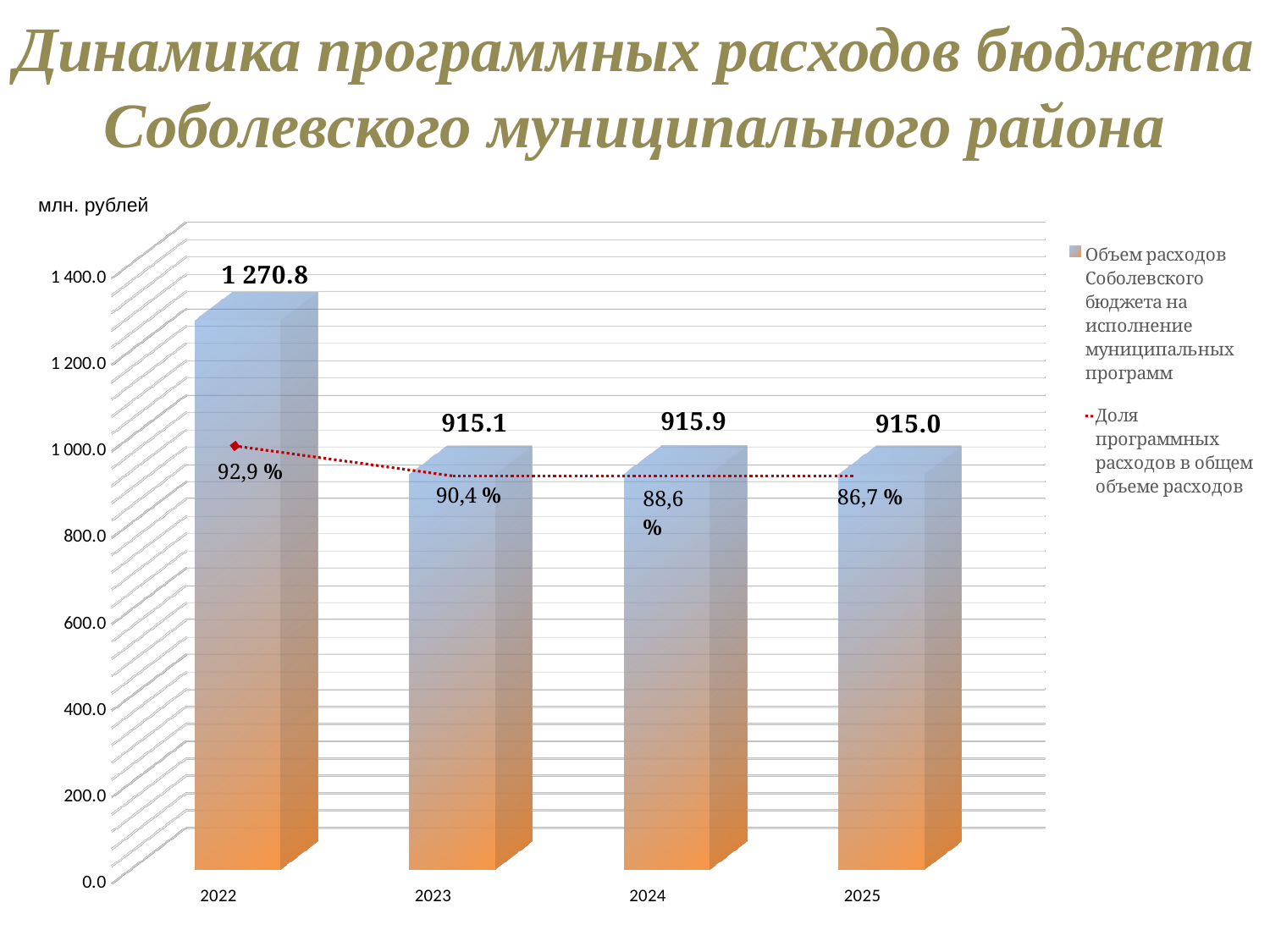
What is the volume of expenditures on municipal programs in 2024? 915.9 What is the difference between the volume of program expenditures in 2022 and in 2023? 355.7 What is the share of program expenditures in total expenditures in 2025? 86,7 % Which year has the highest volume of expenditures on municipal programs? 2022 Does the share of program expenditures in total expenditures rise or fall from 2022 to 2025? fall What is the volume of expenditures of the Sobolevsky budget on municipal programs in 2022? 1 270.8 Is the volume of program expenditures in 2022 larger or smaller than in 2025? larger Is the volume of program expenditures in 2023 greater or less than 1 000.0? less Which year has the lowest share of program expenditures in total expenditures? 2025 How many years are shown on the x axis? 4 How many series does the legend list? 2 What is the share of program expenditures in total expenditures in 2023? 90,4 %